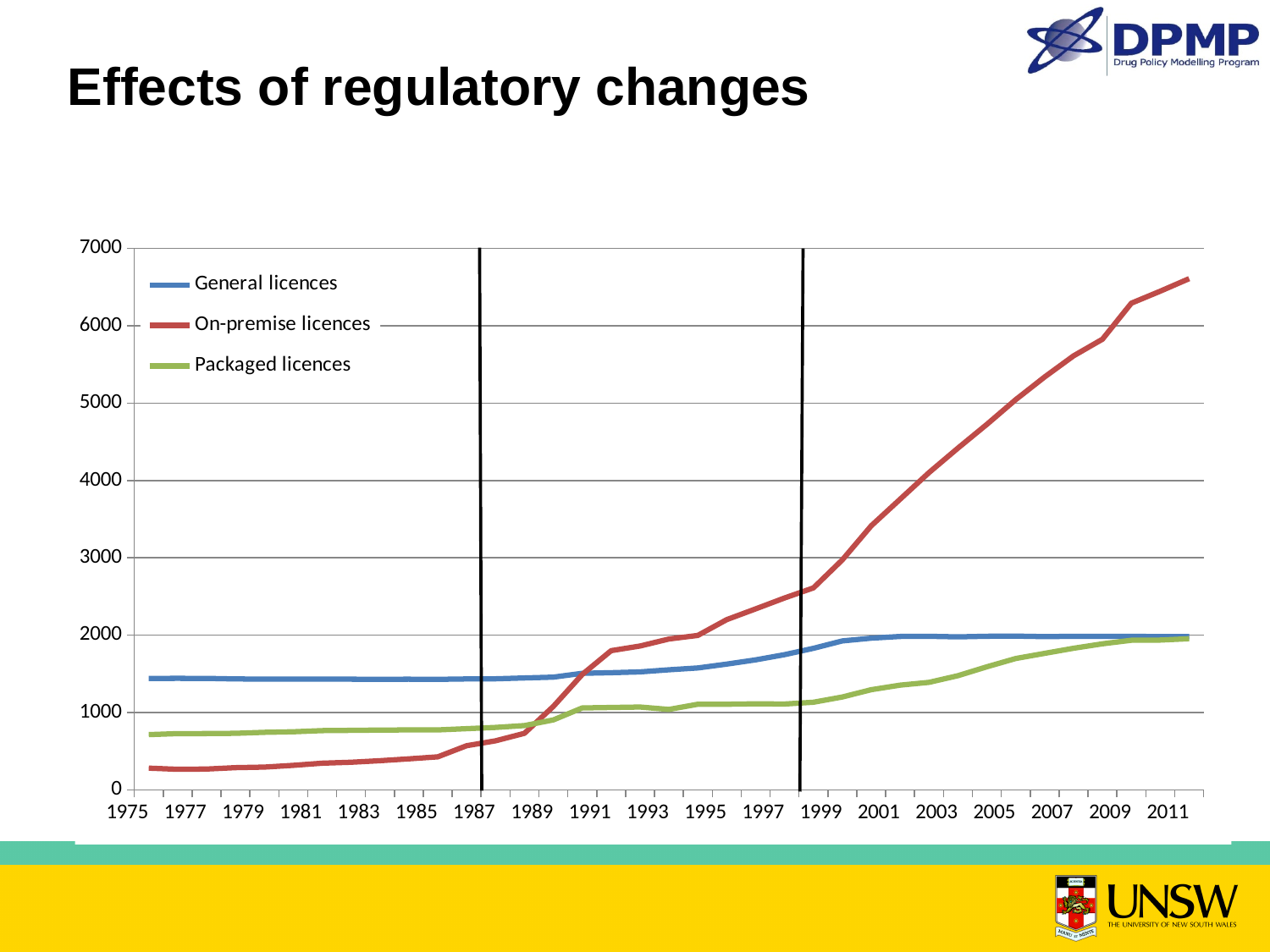
Is the value for On-premise licences in 2003 greater or less than 3000? greater Do the values for On-premise licences rise or fall from 1975 to 2011? rise How many series does the legend list? 3 In 2011, which is larger: On-premise licences or Packaged licences? On-premise licences In 1975, which is larger: General licences or On-premise licences? General licences What kind of chart is shown on the slide? Line chart Is the value for Packaged licences in 1975 greater or less than 1000? less Is the value for General licences in 2011 greater or less than 3000? less Which series has the highest value in 2011? On-premise licences What colour is the line for On-premise licences? Red Which series has the lowest value in 1975? On-premise licences